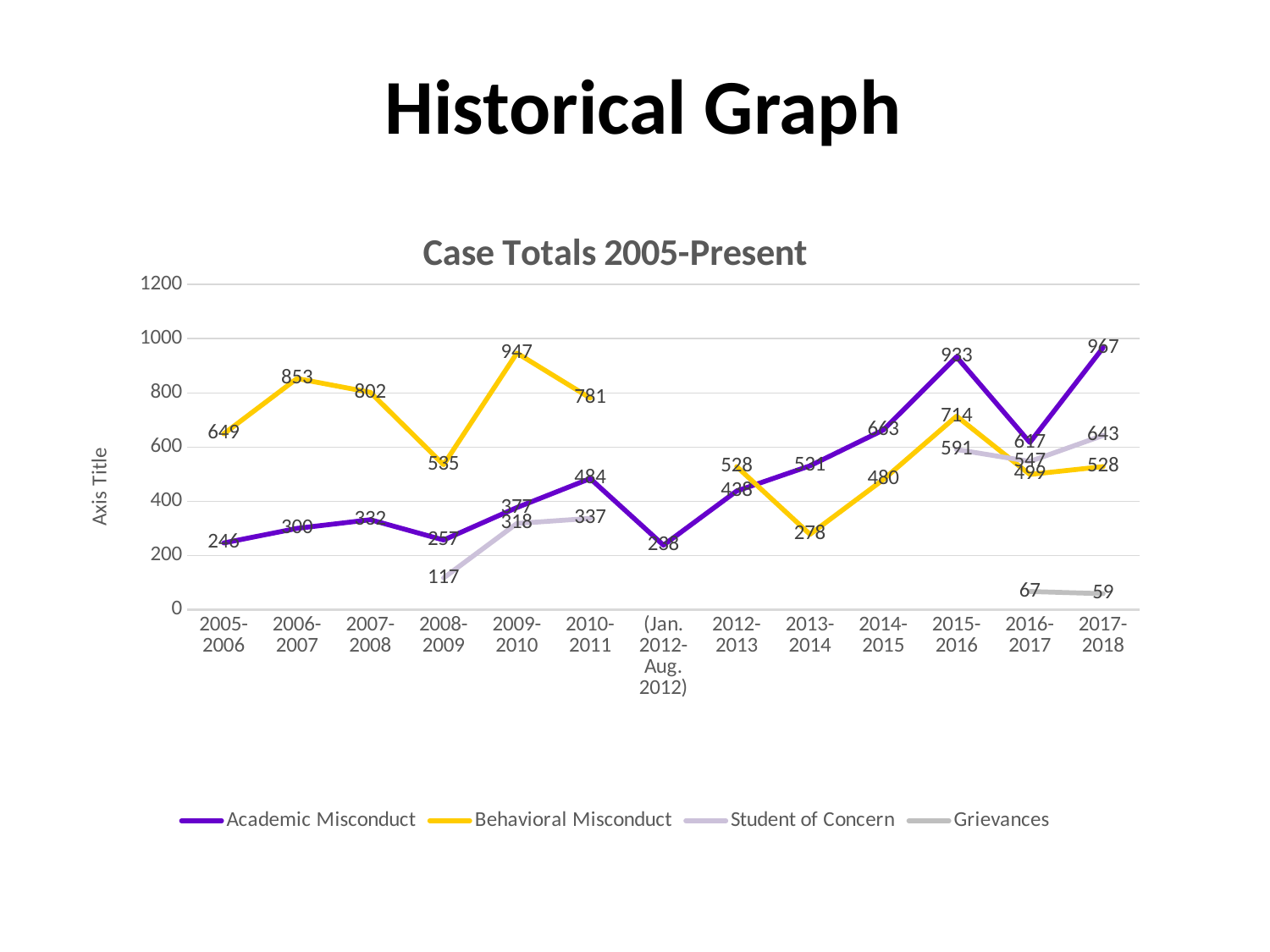
What kind of chart is shown on the slide? line chart What is the Academic Misconduct value for 2017-2018? 967 What is the Behavioral Misconduct value for 2009-2010? 947 What is the Grievances value for 2017-2018? 59 What is the title of the chart? Case Totals 2005-Present How many series does the legend list? 4 How many time periods are shown on the x axis? 13 What is the difference between the Academic Misconduct values for 2017-2018 and 2015-2016? 34 In which period is Behavioral Misconduct lowest? 2013-2014 In which period is Behavioral Misconduct highest? 2009-2010 In 2006-2007, which is larger: Academic Misconduct or Behavioral Misconduct? Behavioral Misconduct Is the Student of Concern value for 2008-2009 greater or less than 200? less